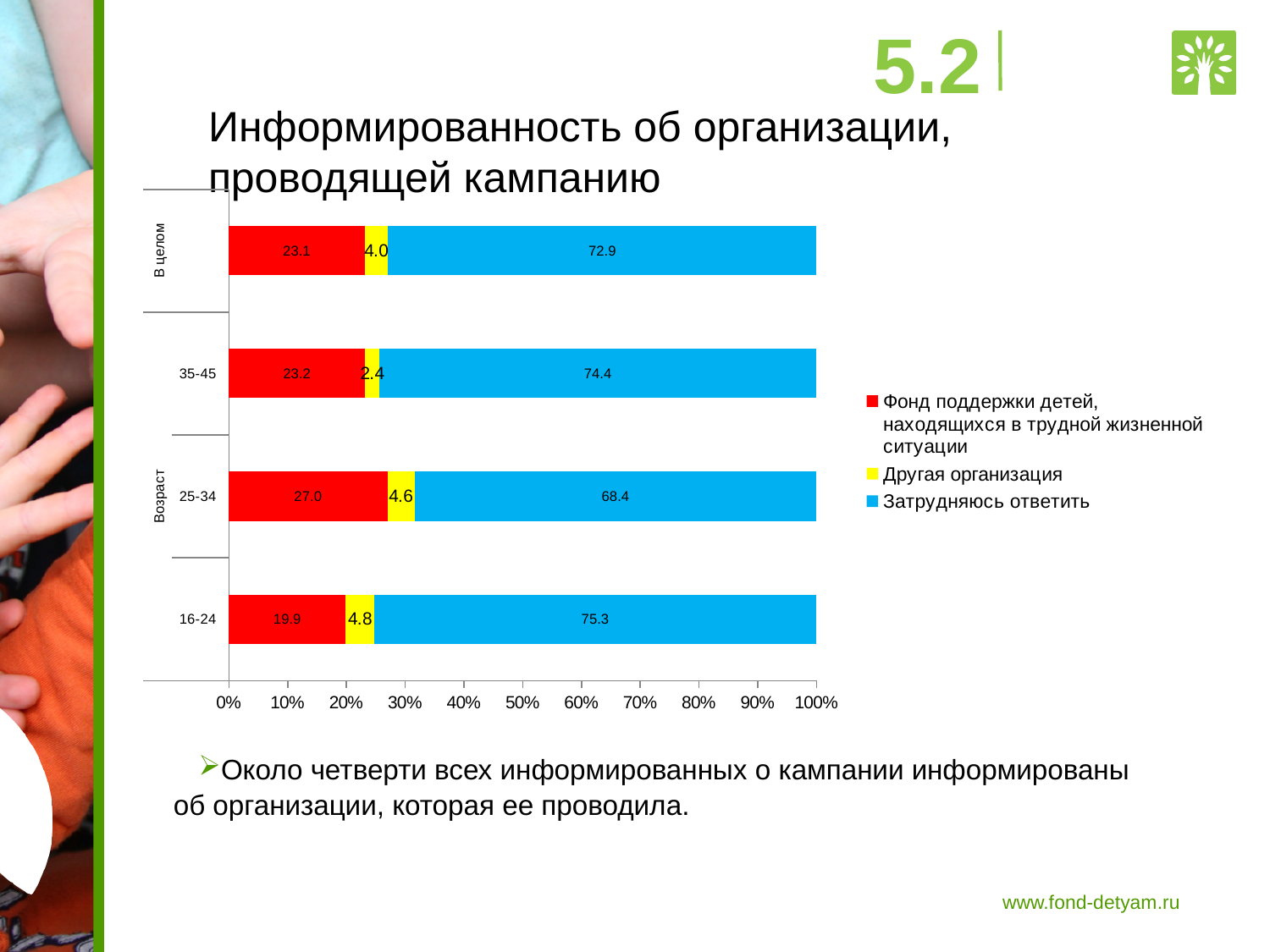
What value is shown for "Фонд поддержки детей, находящихся в трудной жизненной ситуации" in the "В целом" bar? 23.1 How many categories (bars) are shown on the chart? 4 What value is shown for "Затрудняюсь ответить" in the "35-45" bar? 74.4 What kind of chart is shown on the slide? Stacked bar chart What colour represents "Затрудняюсь ответить" in the chart? Blue What is the difference between the "Затрудняюсь ответить" values for the 16-24 and 25-34 groups? 6.9 What value is shown for "Другая организация" in the "16-24" bar? 4.8 How many series does the legend list? 3 Which is larger: the "Фонд поддержки детей" value for 16-24 or for 35-45? 35-45 Which age group has the lowest value for "Другая организация"? 35-45 What value is shown for "Затрудняюсь ответить" in the "25-34" bar? 68.4 Which age group has the highest value for "Фонд поддержки детей, находящихся в трудной жизненной ситуации"? 25-34